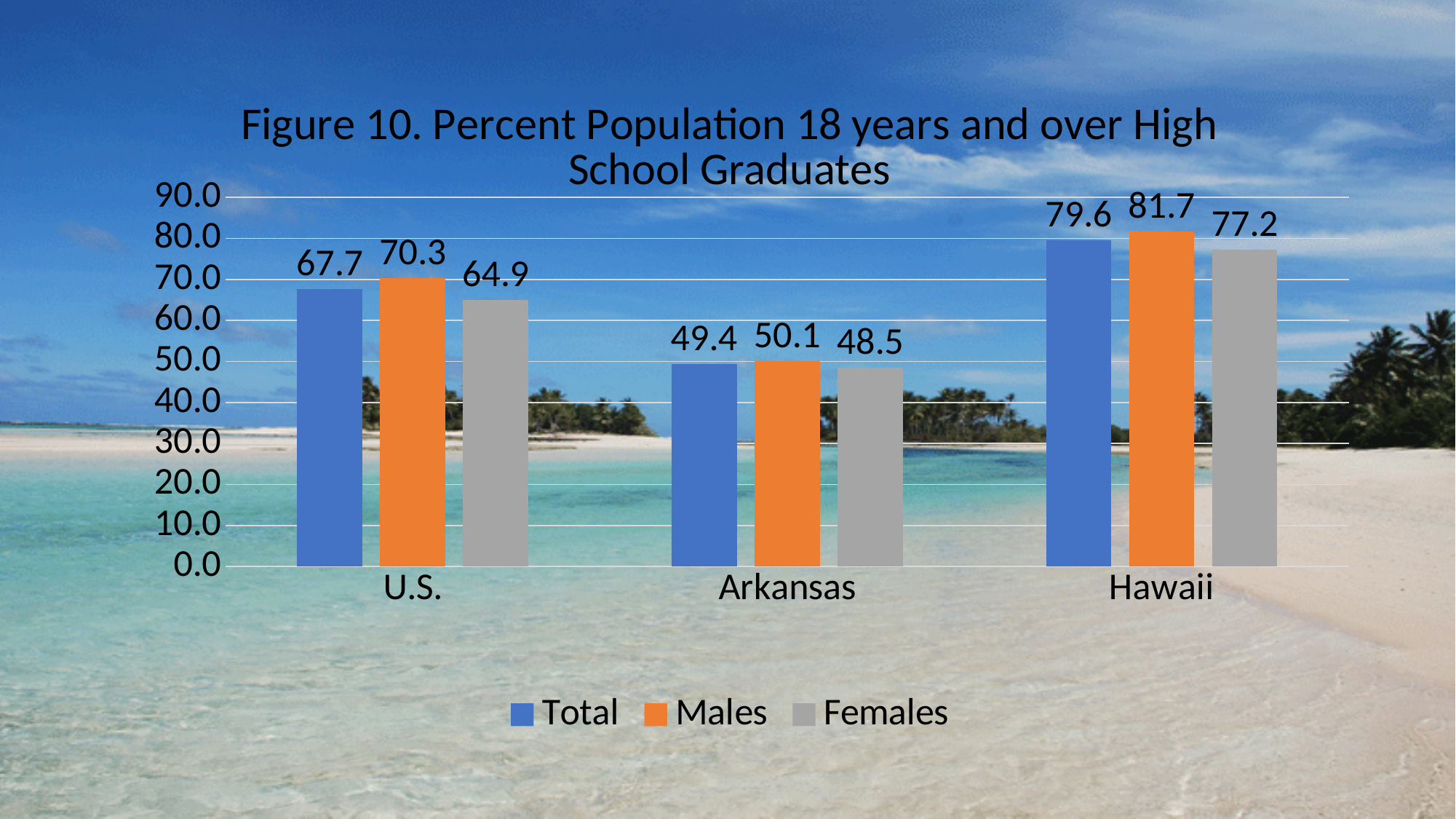
Which is larger, the Males value for the U.S. or the Females value for Hawaii? Females value for Hawaii What is the Males value for Arkansas? 50.1 How many series does the legend list? 3 What is the Females value for the U.S.? 64.9 Is the Total value for Arkansas greater or less than 60.0? less Which category has the highest Males value? Hawaii What kind of chart is shown on the slide? bar chart What is the difference between the Males and Females values for Hawaii? 4.5 What is the difference between the Total values for Hawaii and Arkansas? 30.2 How many categories are shown on the x axis? 3 Which category has the lowest Females value? Arkansas What is the Total value for Hawaii? 79.6